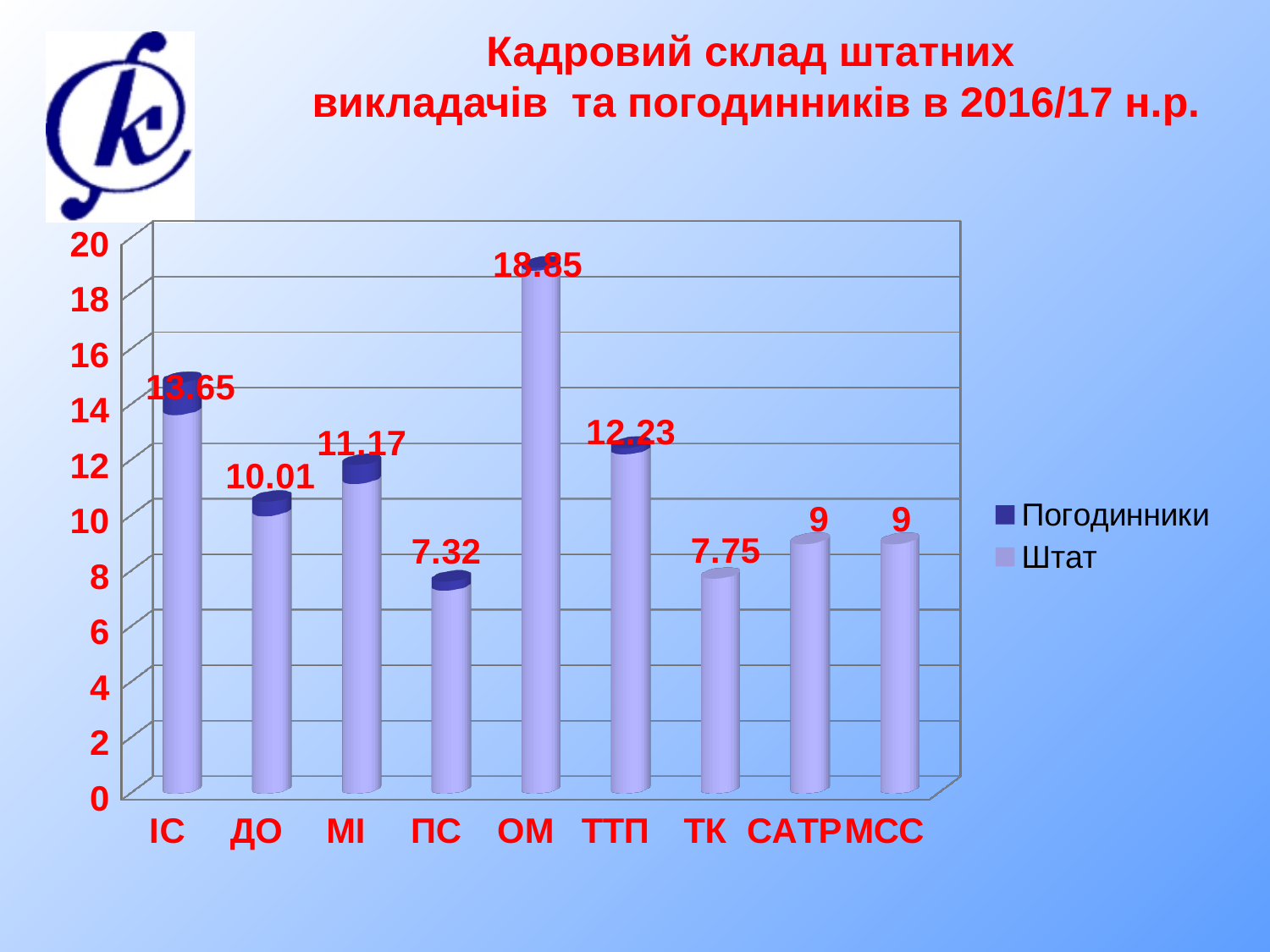
What are the two entries in the legend? Погодинники and Штат How many series does the legend list? 2 Is the value for ТК greater or less than 8? less What kind of chart is shown on the slide? bar chart What value is labelled on the bar for ПС? 7.32 What value is labelled on the bar for ОМ? 18.85 How many categories are shown on the x axis? 9 Which bar is taller, ІС or ТТП? ІС What value is labelled on the bar for САТР? 9 Which category has the highest bar? ОМ What is the difference between the labelled values for ОМ and ІС? 5.2 Which category has the lowest bar? ПС